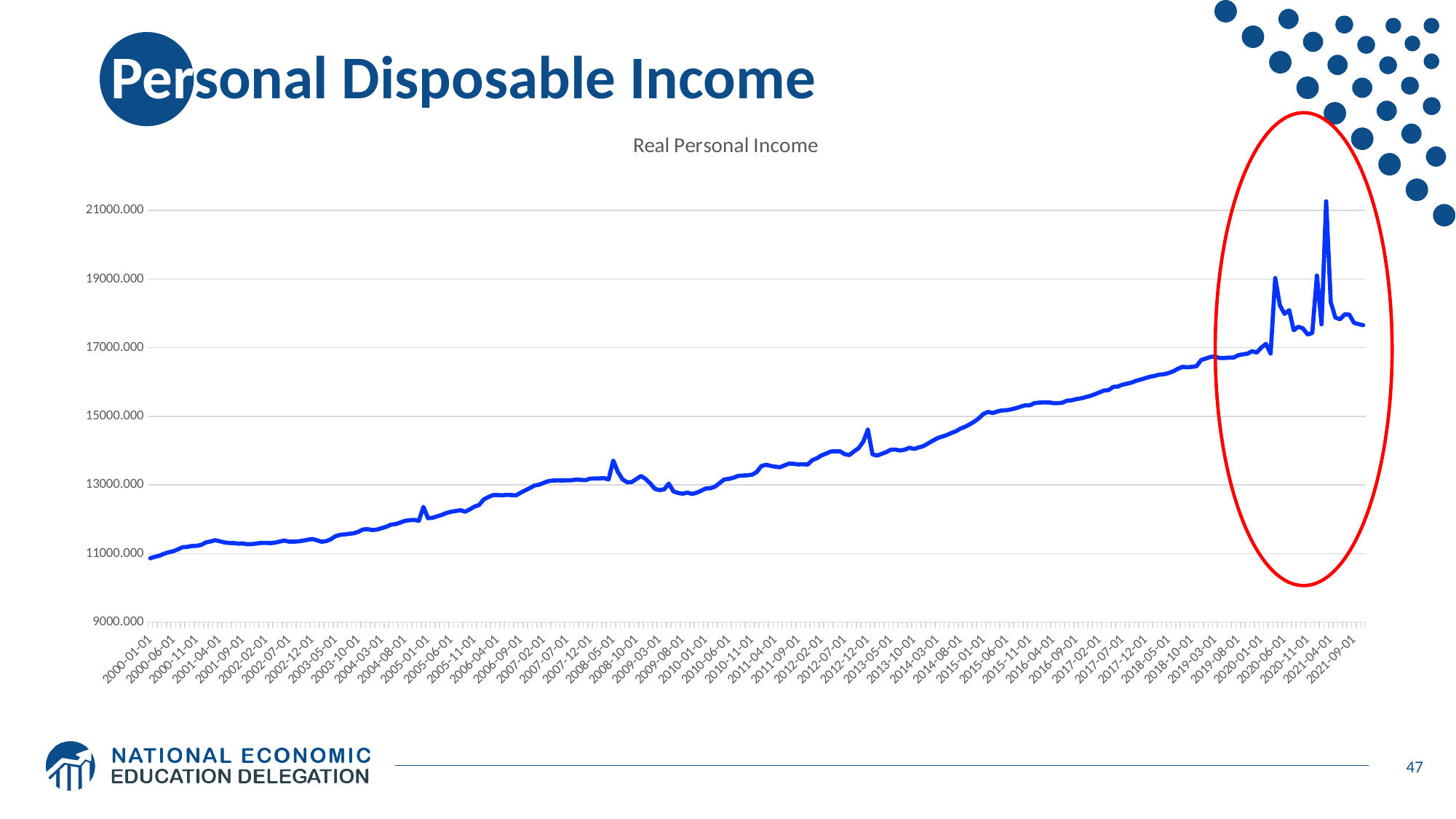
Is the value at 2005-06-01 greater or less than 13000.000? less Which is larger, the value at 2020-01-01 or the value at 2010-01-01? 2020-01-01 Is the value at 2019-03-01 greater or less than 15000.000? greater What colour is the shape drawn around the 2020-2021 portion of the line? red In which year does the highest value of the line occur? 2021 What kind of chart is shown on the slide? line chart What is the title of the chart? Real Personal Income Is the value at 2000-01-01 greater or less than 11000.000? less Overall, do the values rise or fall from 2000 to 2021 along the x axis? rise At which date on the x axis is the line at its lowest value? 2000-01-01